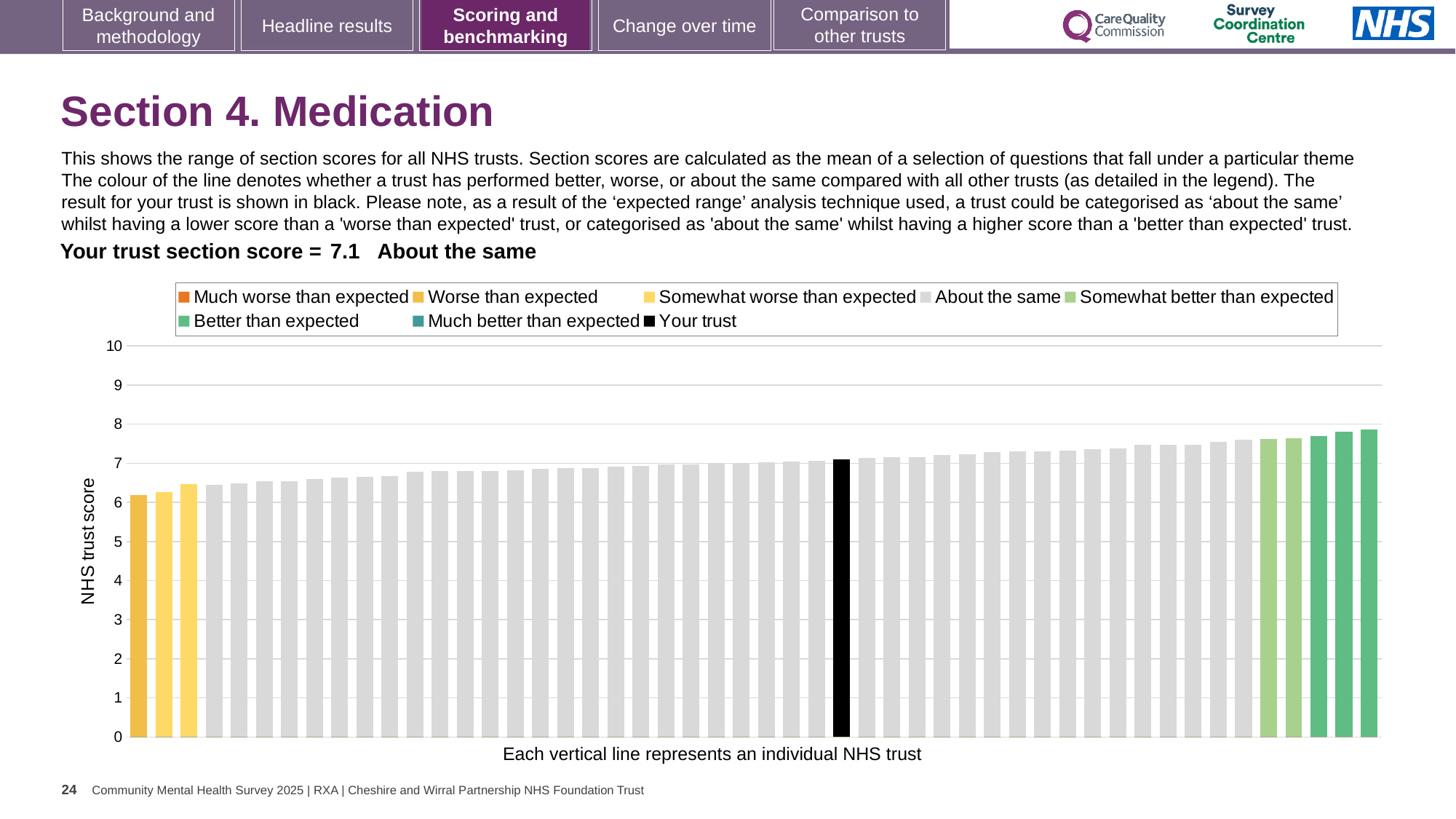
What colour is used for the bar representing your trust? Black How many entries does the chart legend list? 8 What is the label on the vertical axis of the chart? NHS trust score Is the score of the lowest (leftmost) trust bar greater or less than 6? greater What is the section score for your trust shown on the slide? 7.1 Which is larger: the leftmost bar or the rightmost bar? The rightmost bar Is the score of the highest (rightmost) trust bar greater or less than 8? less How many bars are coloured as 'Worse than expected' or 'Somewhat worse than expected' (yellow/orange)? 3 Do the trust scores rise or fall from left to right along the x axis? Rise Is the score for your trust (black bar) greater or less than 5? greater Which performance category is your trust placed in for Section 4. Medication? About the same What type of chart is shown on the slide? Bar chart